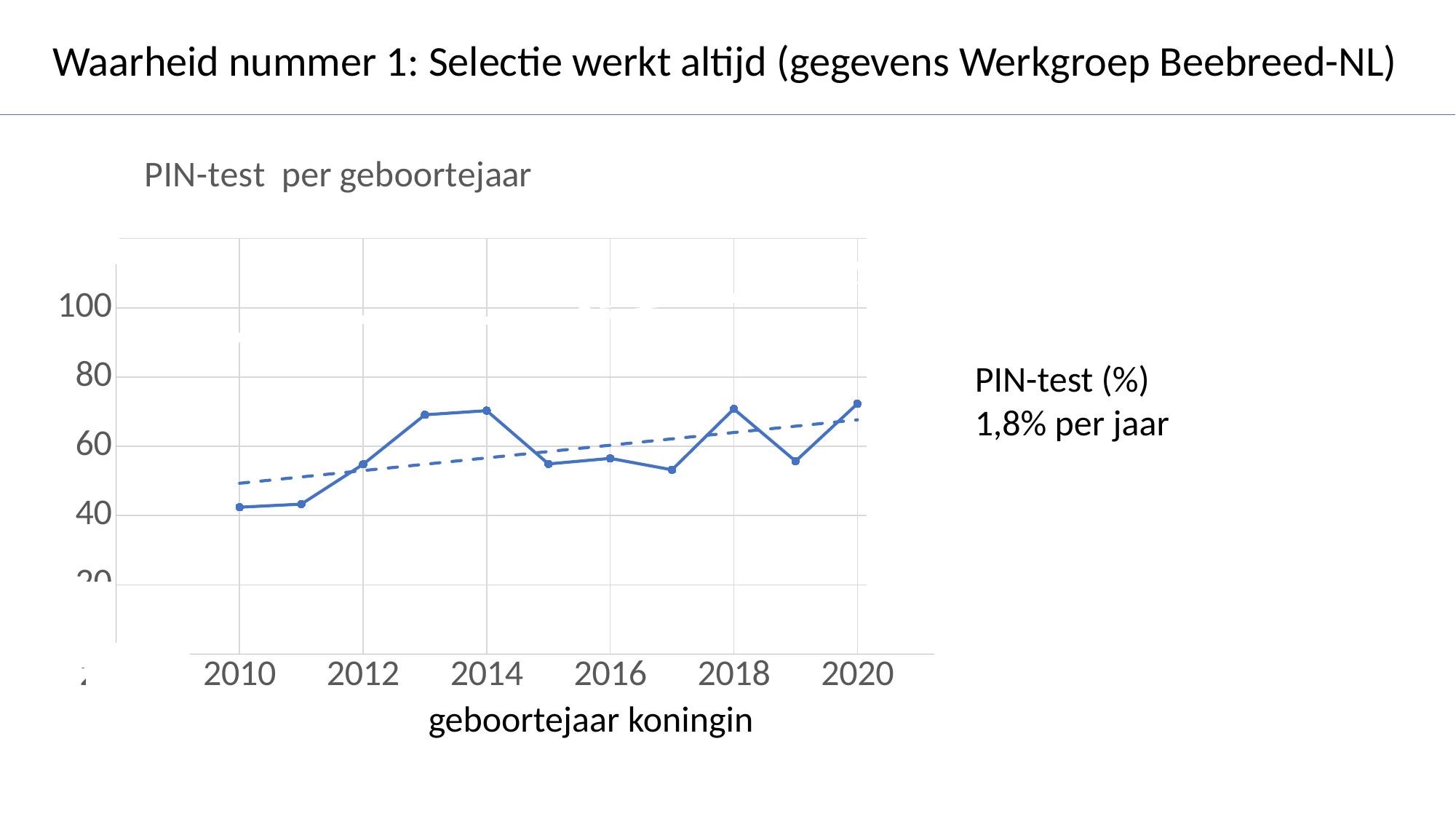
Is the value for 2020 greater or less than 60? greater Is the value for 2010 greater or less than 60? less Which has the higher value, 2014 or 2015? 2014 According to the dashed trend line, do the values generally rise or fall from 2010 to 2020? rise Which has the higher value, 2013 or 2010? 2013 What is the label of the x axis of the chart? geboortejaar koningin Is the value for 2013 greater or less than 60? greater What kind of chart is shown on the slide? line chart How many data points are plotted on the line in the chart? 11 What is the title of the chart? PIN-test per geboortejaar